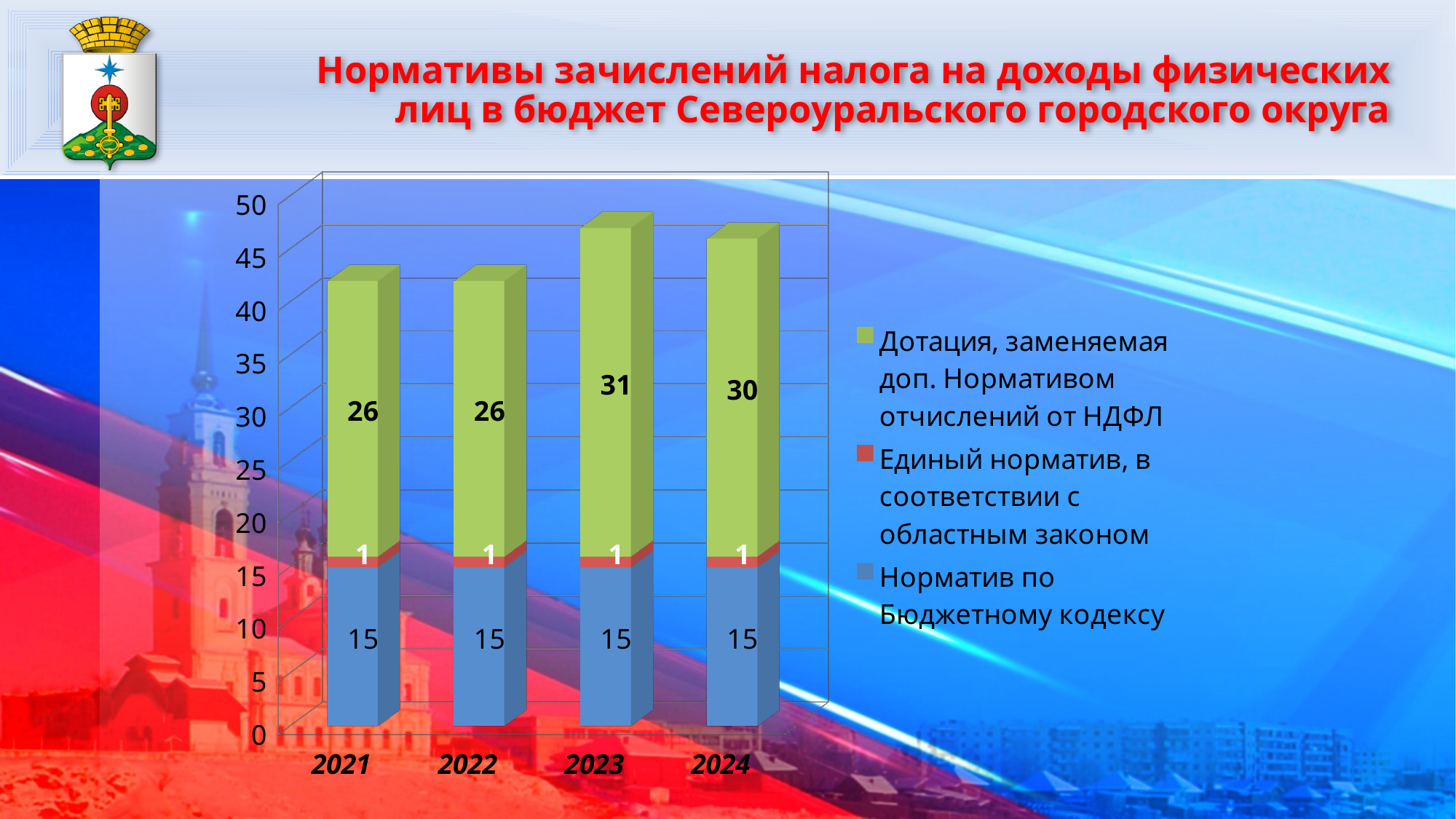
In which year is the green series (Дотация, заменяемая доп. Нормативом отчислений от НДФЛ) highest? 2023 How many years are shown on the x axis? 4 Which colour represents the series Норматив по Бюджетному кодексу? Blue What is the difference between the green series values for 2023 and 2022? 5 What is the total of the stacked bar for 2023? 47 What is the value of the blue series (Норматив по Бюджетному кодексу) for 2021? 15 What is the value of the red series (Единый норматив, в соответствии с областным законом) for 2024? 1 How many series does the legend list? 3 What is the total of the stacked bar for 2021? 42 What kind of chart is shown on the slide? Stacked bar chart What is the value of the green series (Дотация, заменяемая доп. Нормативом отчислений от НДФЛ) for 2023? 31 Which is larger: the green series value for 2024 or for 2021? 2024